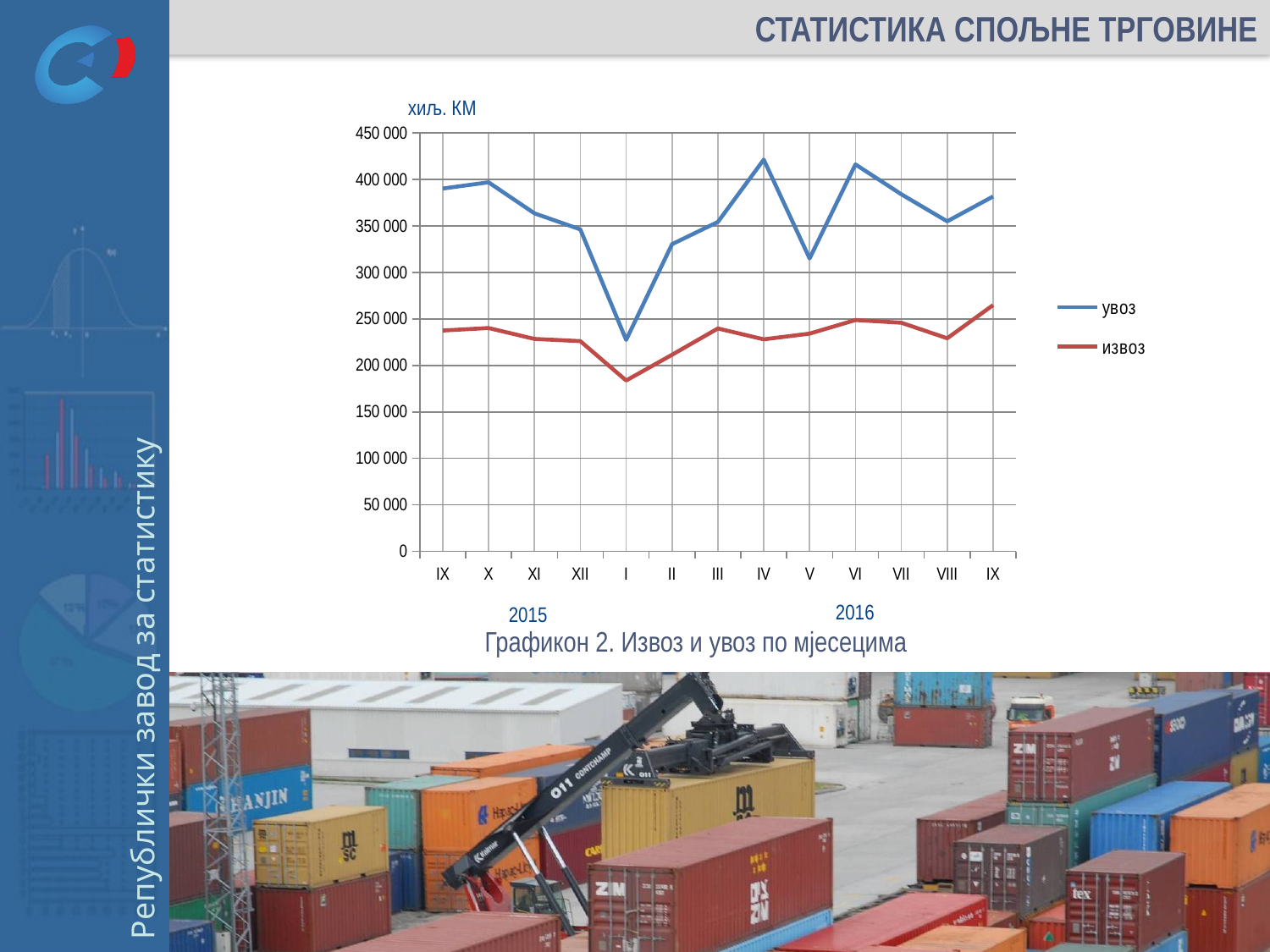
What unit is shown above the vertical axis? хиљ. КМ Which series has the larger value in month IX of 2015, увоз or извоз? увоз Is the value for увоз in month IV of 2016 greater or less than 400 000? greater In which month is the value for извоз lowest? I (2016) Is the value for извоз in month I of 2016 greater or less than 200 000? less Is the value for увоз in month I of 2016 greater or less than 250 000? less What are the two series named in the legend? увоз and извоз How many months are plotted along the x axis? 13 In which month is the value for извоз highest? IX (2016) In which month is the value for увоз lowest? I (2016) What kind of chart is shown on the slide? line chart How many series does the legend list? 2